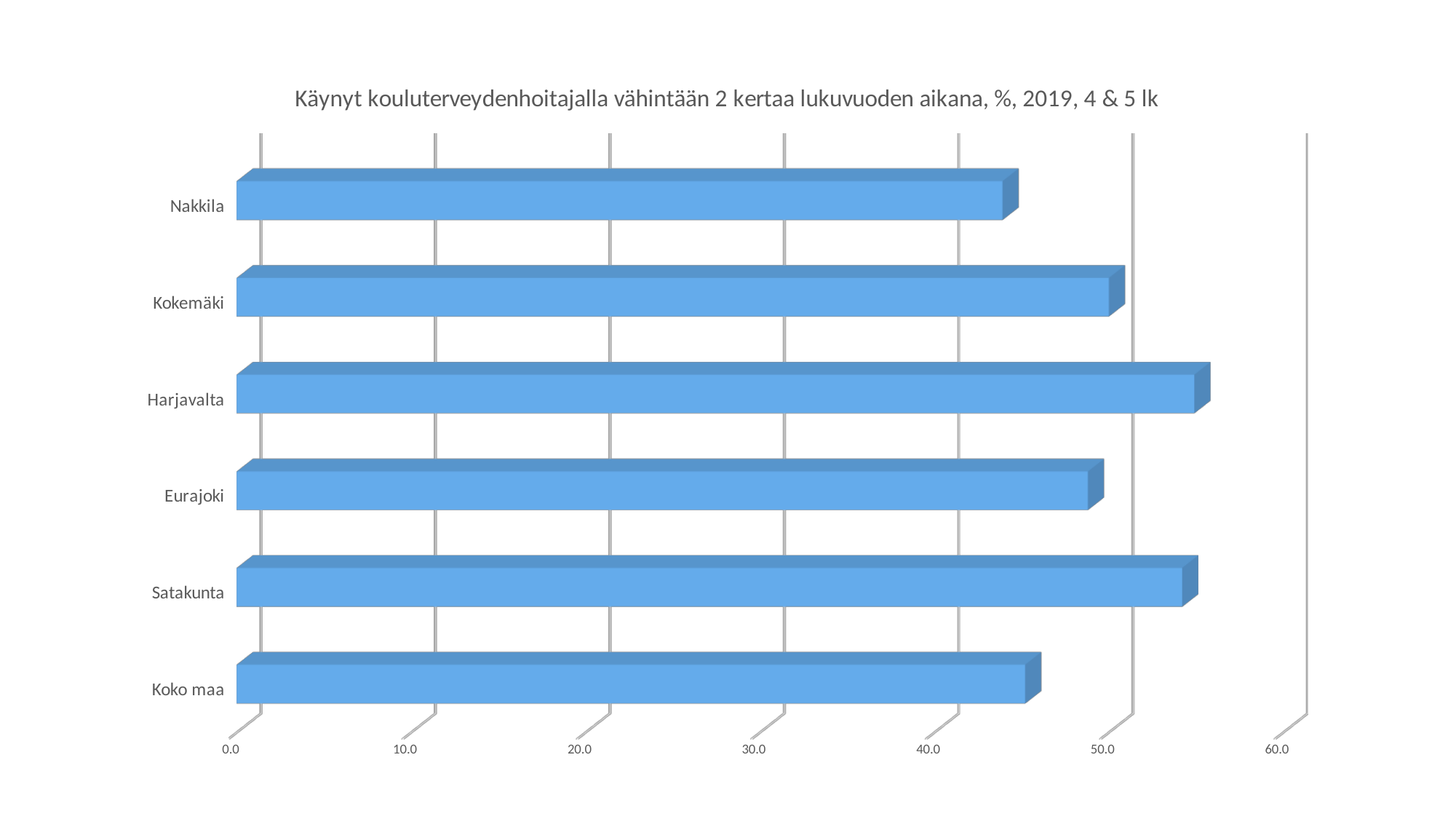
What is the title of the chart? Käynyt kouluterveydenhoitajalla vähintään 2 kertaa lukuvuoden aikana, %, 2019, 4 & 5 lk Is the value for Satakunta greater or less than 50? greater Which has the larger value, Harjavalta or Nakkila? Harjavalta What kind of chart is shown on the slide? bar chart Which has the larger value, Satakunta or Koko maa? Satakunta Is the value for Koko maa greater or less than 50? less Which has the larger value, Eurajoki or Koko maa? Eurajoki Is the value for Harjavalta greater or less than 50? greater How many categories (bars) does the chart show? 6